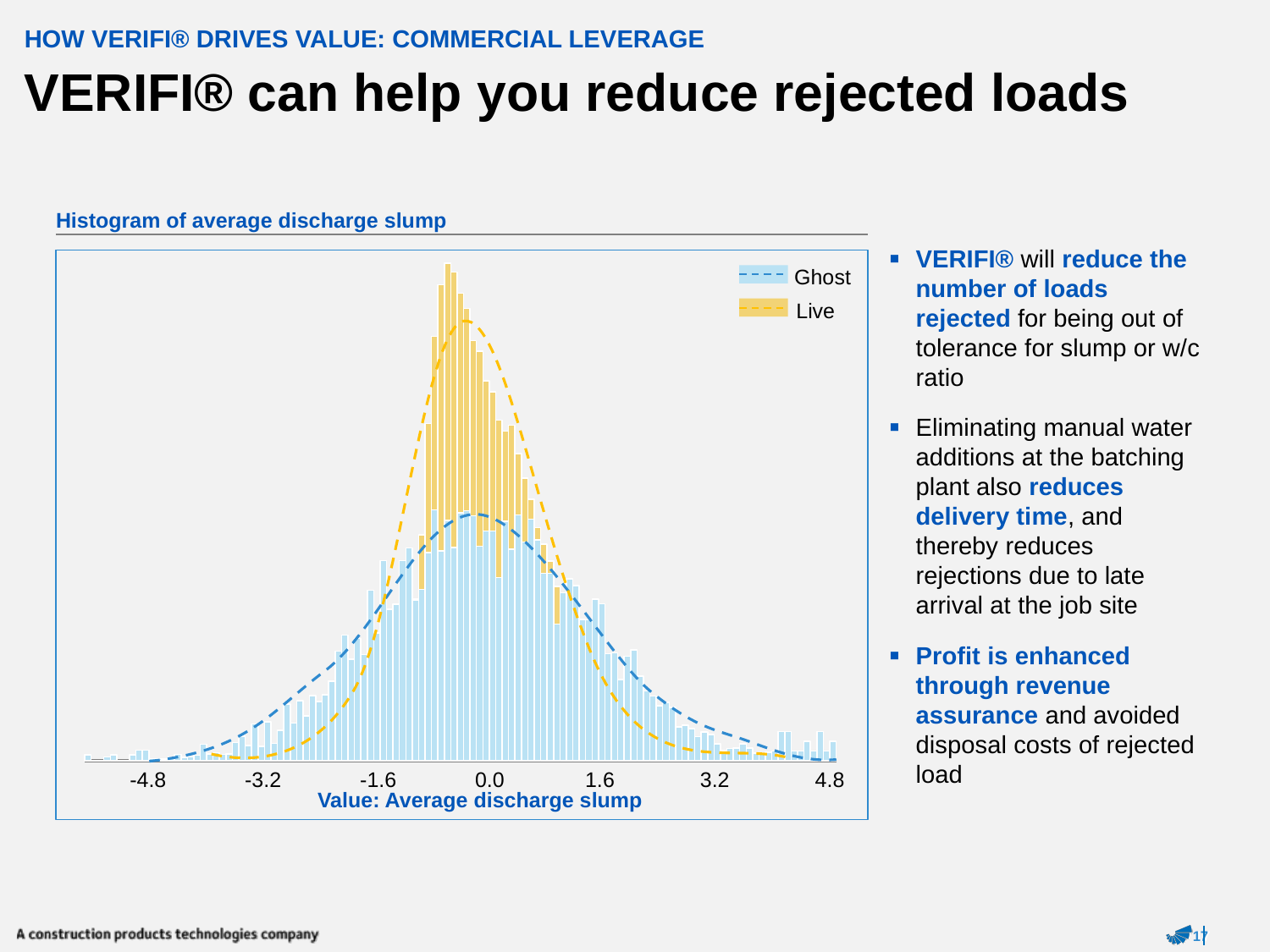
What is the label of the x axis of the chart? Value: Average discharge slump How many series does the chart legend list? 2 How many tick labels are shown on the x axis? 7 What kind of chart is shown on the slide? Histogram (bar chart) What is the title of the chart on the slide? Histogram of average discharge slump What are the two series named in the chart legend? Ghost and Live Which series has the wider, more spread-out distribution, Ghost or Live? Ghost What is the highest tick value shown on the x axis? 4.8 What is the lowest tick value shown on the x axis? -4.8 Which series has the taller peak, Ghost or Live? Live